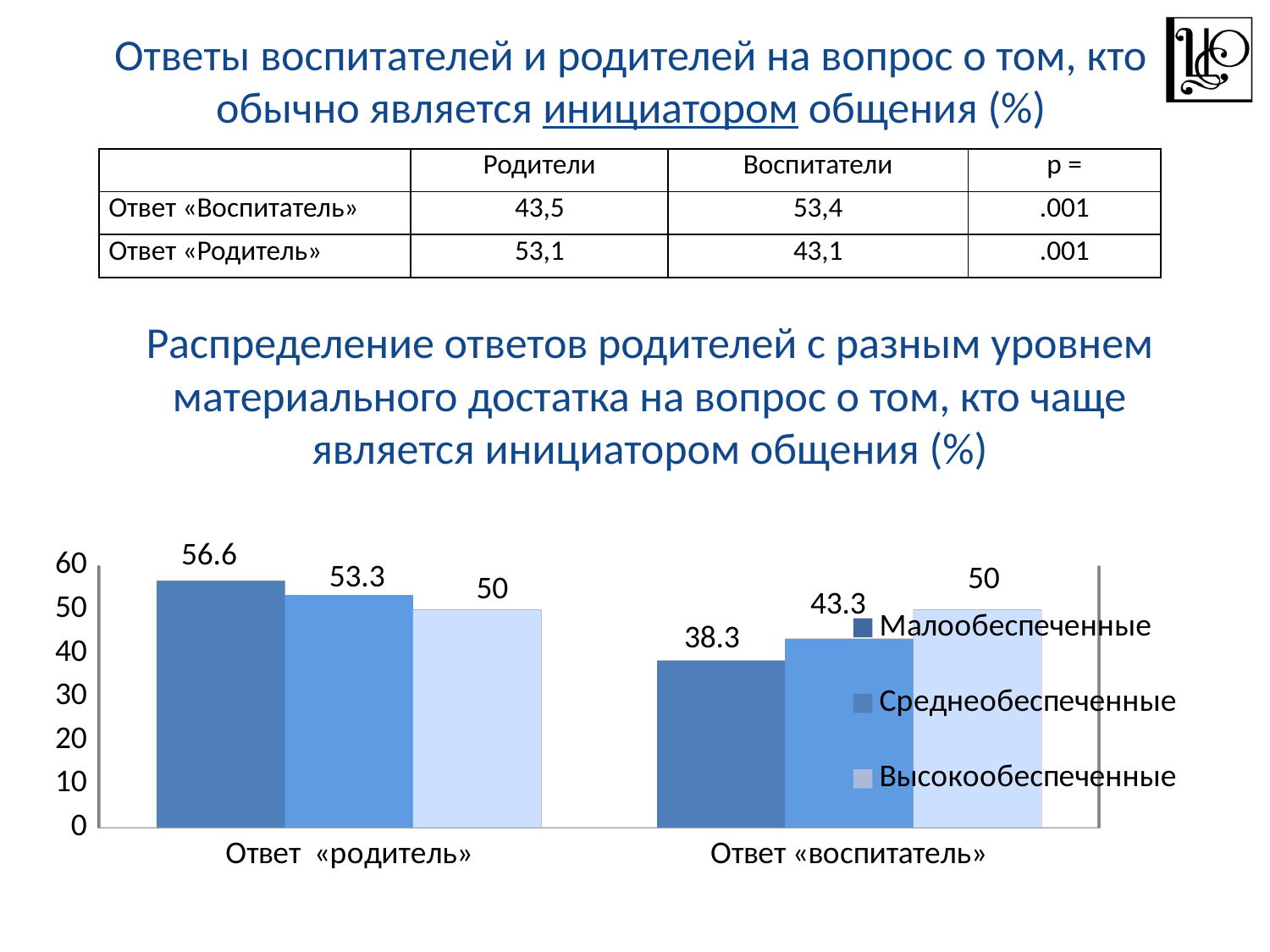
Which series has the lowest value in the Ответ «воспитатель» category? Малообеспеченные What is the difference between the Малообеспеченные values for Ответ «родитель» and Ответ «воспитатель»? 18.3 Which is larger: the Среднеобеспеченные value for Ответ «родитель» or for Ответ «воспитатель»? Ответ «родитель» Is the value for Малообеспеченные in the Ответ «воспитатель» category greater or less than 40? less What is the value for Высокообеспеченные in the Ответ «родитель» category? 50 How many series does the chart legend list? 3 What kind of chart is shown on the slide? bar chart What is the difference between the Высокообеспеченные and Малообеспеченные values in the Ответ «воспитатель» category? 11.7 What is the value for Среднеобеспеченные in the Ответ «воспитатель» category? 43.3 Which series has the highest value in the Ответ «родитель» category? Малообеспеченные How many categories are shown on the x axis of the chart? 2 What is the value for Малообеспеченные in the Ответ «родитель» category? 56.6